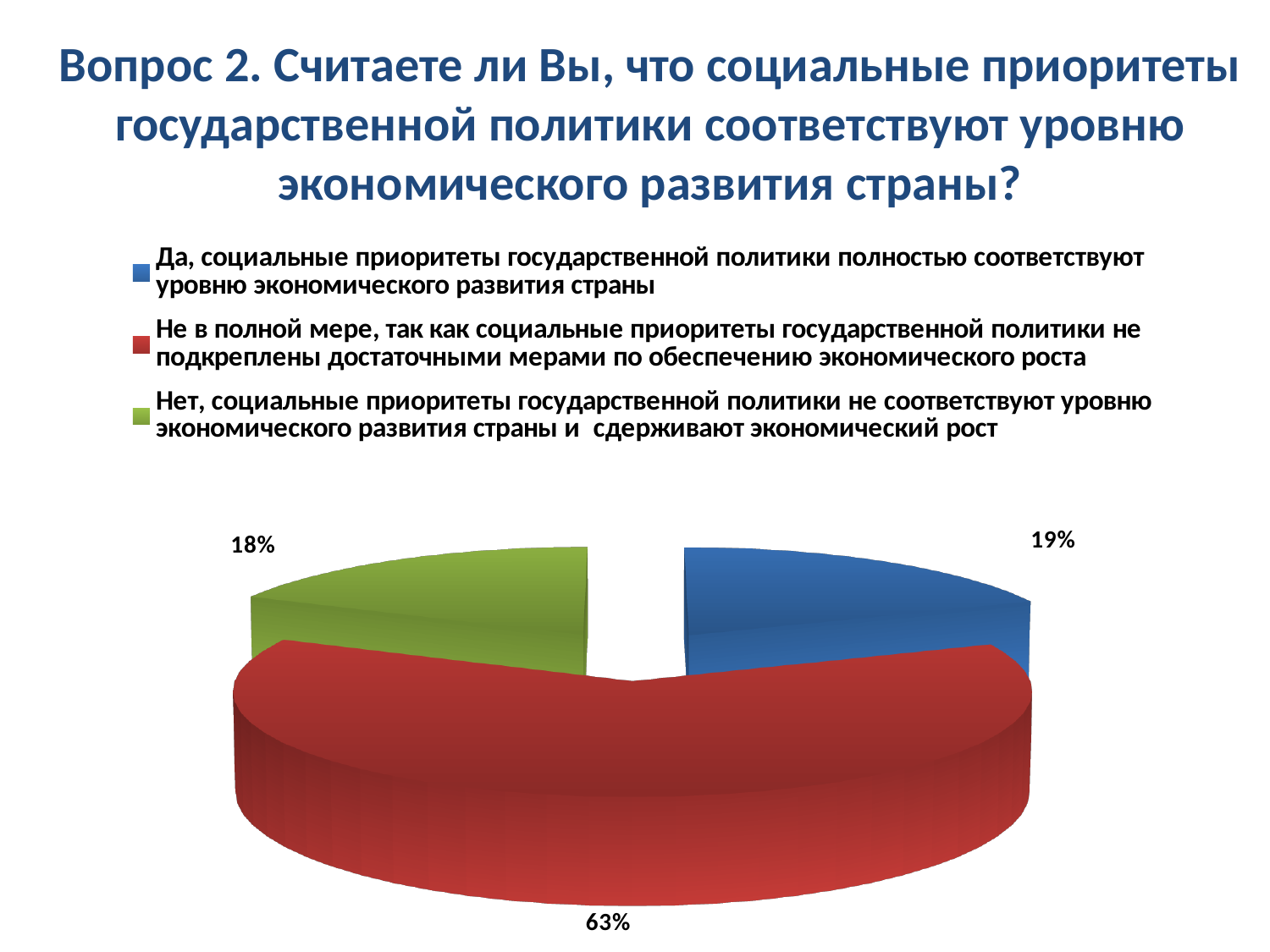
What type of chart is shown on the slide? pie chart What share of respondents answered "Нет, социальные приоритеты государственной политики не соответствуют уровню экономического развития страны и сдерживают экономический рост"? 18% What colour is the slice representing the "Да" answer? blue Which is larger: the share for "Не в полной мере" or the share for "Нет"? Не в полной мере Which answer option has the smallest share of the pie? Нет, социальные приоритеты государственной политики не соответствуют уровню экономического развития страны и сдерживают экономический рост What share of respondents answered "Не в полной мере, так как социальные приоритеты государственной политики не подкреплены достаточными мерами по обеспечению экономического роста"? 63% What is the difference in percentage points between the "Не в полной мере" slice and the "Да" slice? 44 How many slices does the pie chart have? 3 What colour is the slice representing the "Не в полной мере" answer? red How many entries does the legend list? 3 What share of respondents answered "Да, социальные приоритеты государственной политики полностью соответствуют уровню экономического развития страны"? 19% Which answer option has the largest share of the pie? Не в полной мере, так как социальные приоритеты государственной политики не подкреплены достаточными мерами по обеспечению экономического роста